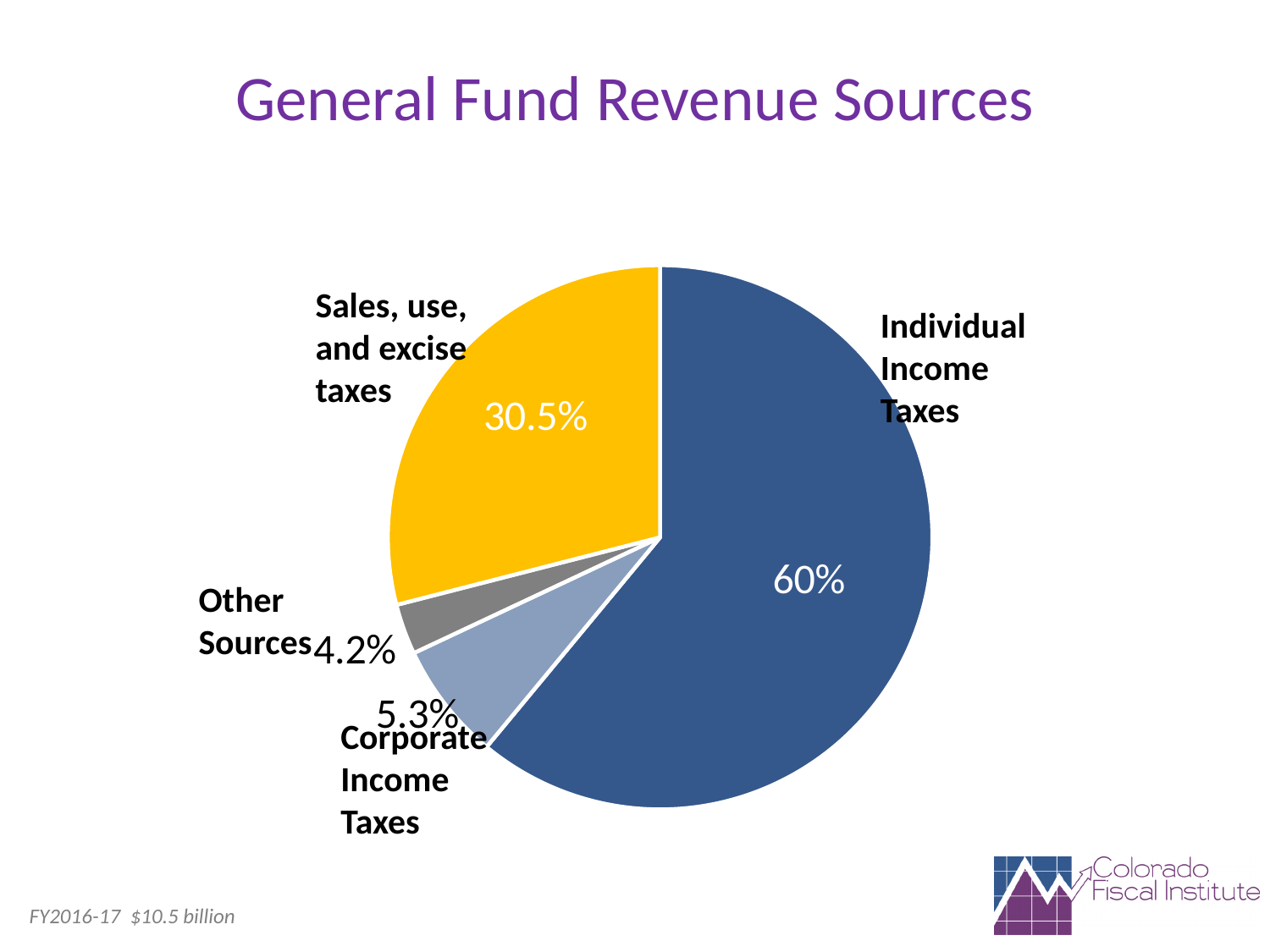
Which is larger, the share for Corporate Income Taxes or the share for Other Sources? Corporate Income Taxes What colour is the Individual Income Taxes slice? dark blue What is the difference in percentage points between Individual Income Taxes and Sales, use, and excise taxes? 29.5 What kind of chart is shown on the slide? pie chart Which revenue source has the smallest share of the pie? Other Sources How many slices does the pie chart have? 4 What share of General Fund revenue comes from Other Sources? 4.2% What share of General Fund revenue comes from Corporate Income Taxes? 5.3% What is the title of the chart? General Fund Revenue Sources What share of General Fund revenue comes from Individual Income Taxes? 60% Which revenue source has the largest share of the pie? Individual Income Taxes What share of General Fund revenue comes from Sales, use, and excise taxes? 30.5%